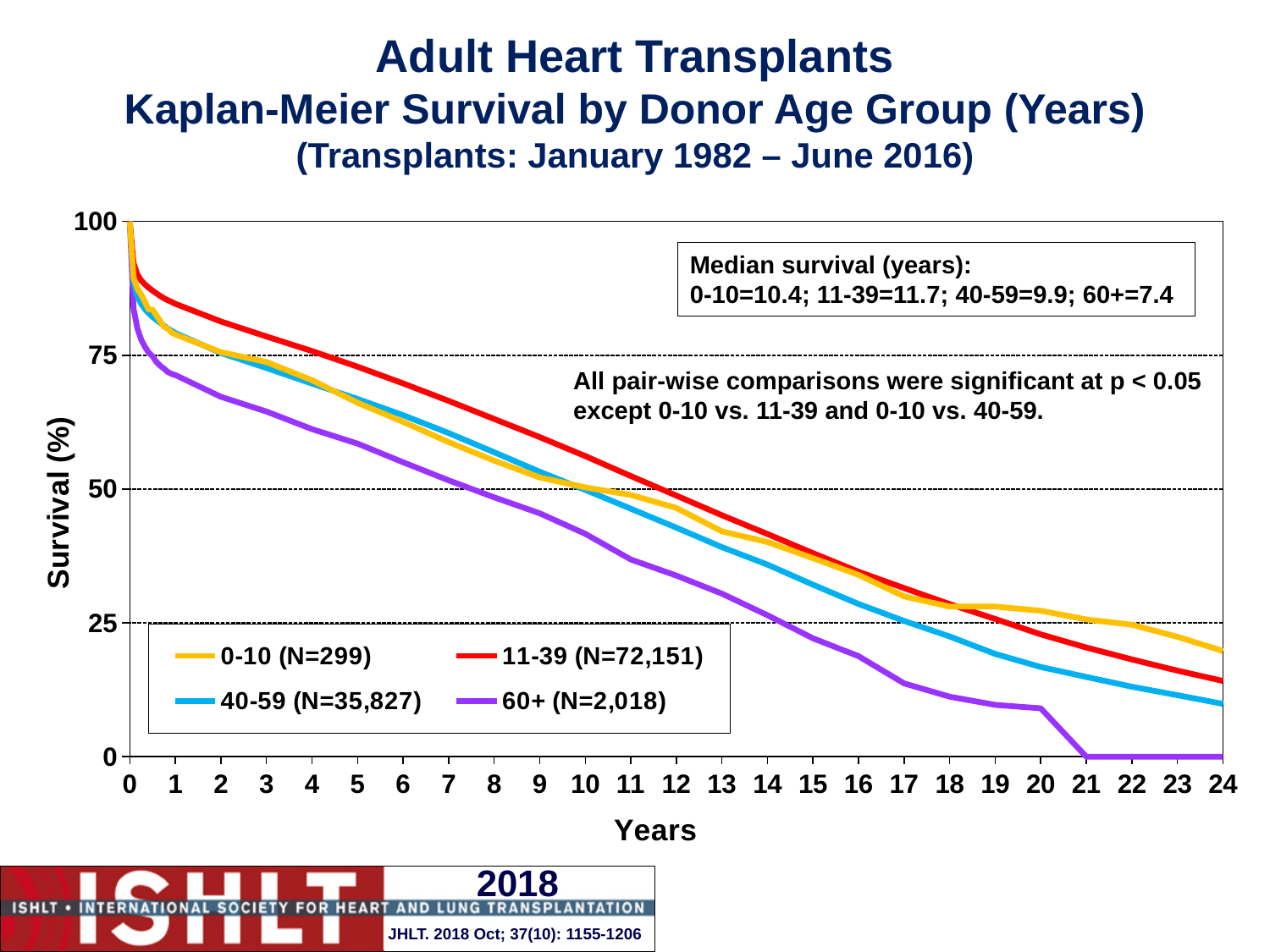
Is the survival value for the 60+ group at 10 years greater or less than 50? less How many donor age groups does the legend list? 4 Is the survival value for the 11-39 group at 10 years greater or less than 50? greater What kind of chart is shown on the slide? line chart Which donor age group has the highest median survival? 11-39 Which has the larger median survival, the 0-10 group or the 40-59 group? 0-10 What is the difference in median survival (years) between the 11-39 and 60+ donor age groups? 4.3 What is the median survival in years for the 60+ donor age group? 7.4 What is the N for the 40-59 donor age group shown in the legend? 35,827 Do the survival curves rise or fall as years increase? fall What is the median survival in years for the 11-39 donor age group? 11.7 Which donor age group has the lowest median survival? 60+